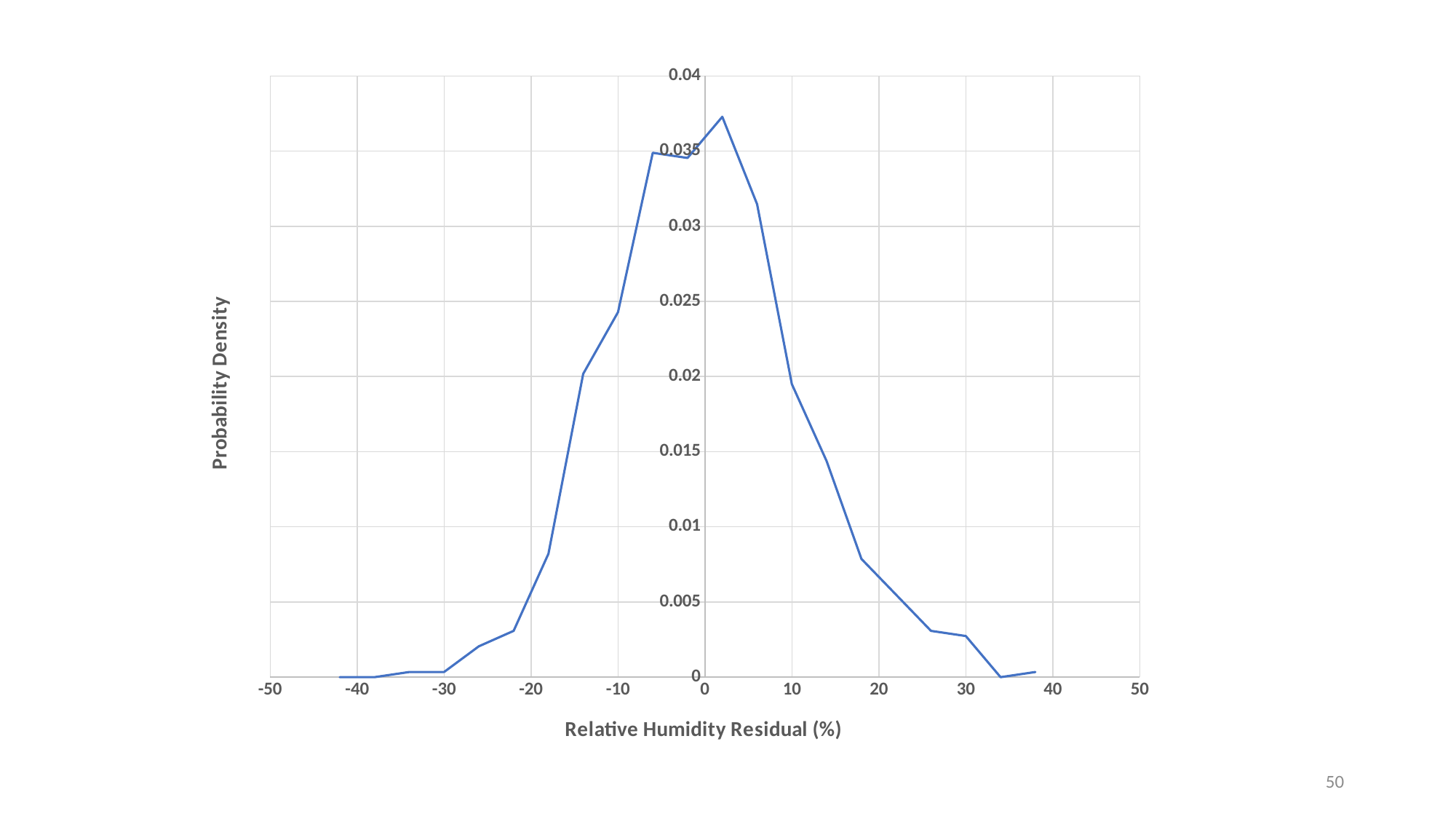
Is the peak value of the curve greater or less than 0.035? greater What kind of chart is shown on the slide? line chart Is the value of the curve at a relative humidity residual of -22 greater or less than 0.005? less What is the title of the x axis? Relative Humidity Residual (%) Is the value of the curve at a relative humidity residual of -18 greater or less than 0.005? greater What is the title of the y axis? Probability Density Which has the higher probability density: a relative humidity residual of -30 or of 30? 30 Does the probability density rise or fall as the relative humidity residual increases from 0 to 40? fall Which has the higher probability density: a relative humidity residual of -10 or of 10? -10